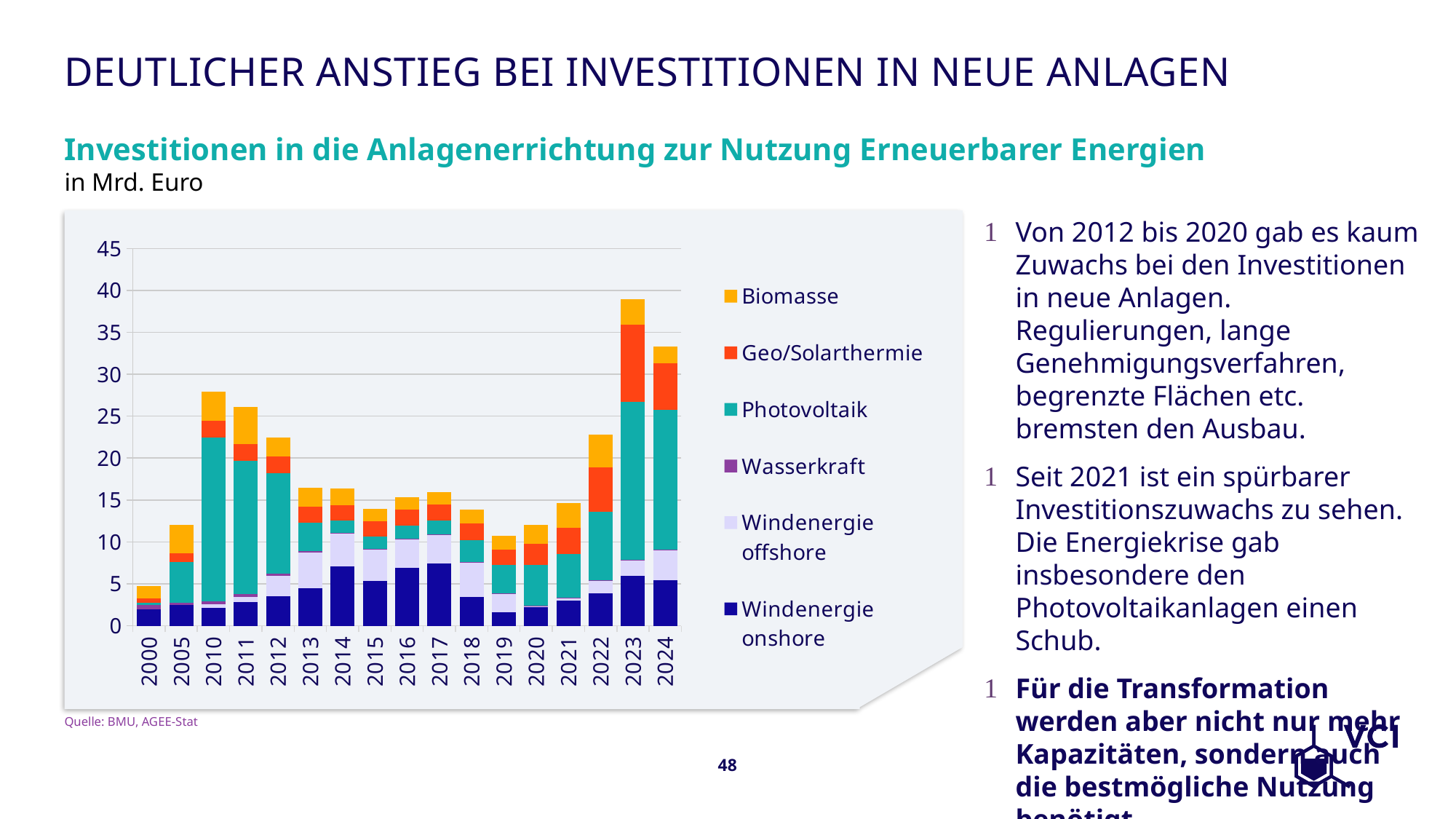
Is the total value for 2000 greater or less than 10? less How many years (bars) are shown on the x axis of the chart? 17 Which year has the highest total investment in the chart? 2023 What kind of chart is shown on the slide? Stacked bar chart In what unit are the values in the chart given? Mrd. Euro What is the source cited below the chart? BMU, AGEE-Stat Which year has the larger total investment, 2022 or 2024? 2024 How many series does the chart legend list? 6 Which year has the lowest total investment in the chart? 2000 Do the total investments rise or fall from 2021 to 2023? Rise Is the total value for 2019 greater or less than 15? less Is the total value for 2023 greater or less than 35? greater